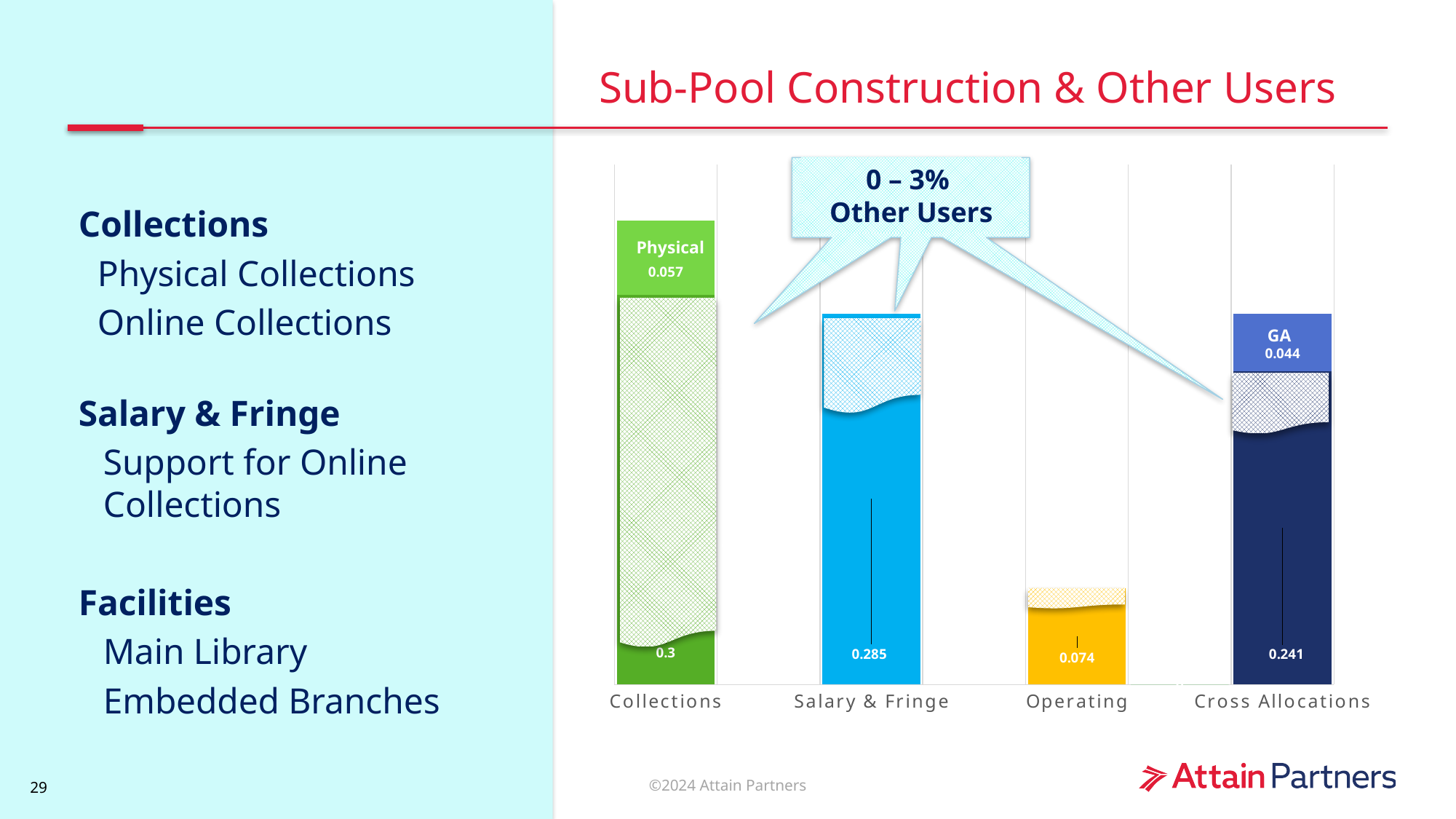
How many categories are shown on the x axis? 4 Which category has the lowest value? Operating What is the value of the main segment of the Cross Allocations bar? 0.241 What is the value shown for Salary & Fringe? 0.285 What is the difference between the main Collections value (0.3) and the Salary & Fringe value (0.285)? 0.015 What is the value shown for Operating? 0.074 What is the total of the Cross Allocations bar including the GA segment? 0.285 What value is labelled on the GA segment on top of the Cross Allocations bar? 0.044 What is the total of the Collections bar including the Physical segment? 0.357 What kind of chart is shown on the slide? Bar chart What is the value of the main segment of the Collections bar? 0.3 What value is labelled on the Physical segment on top of the Collections bar? 0.057